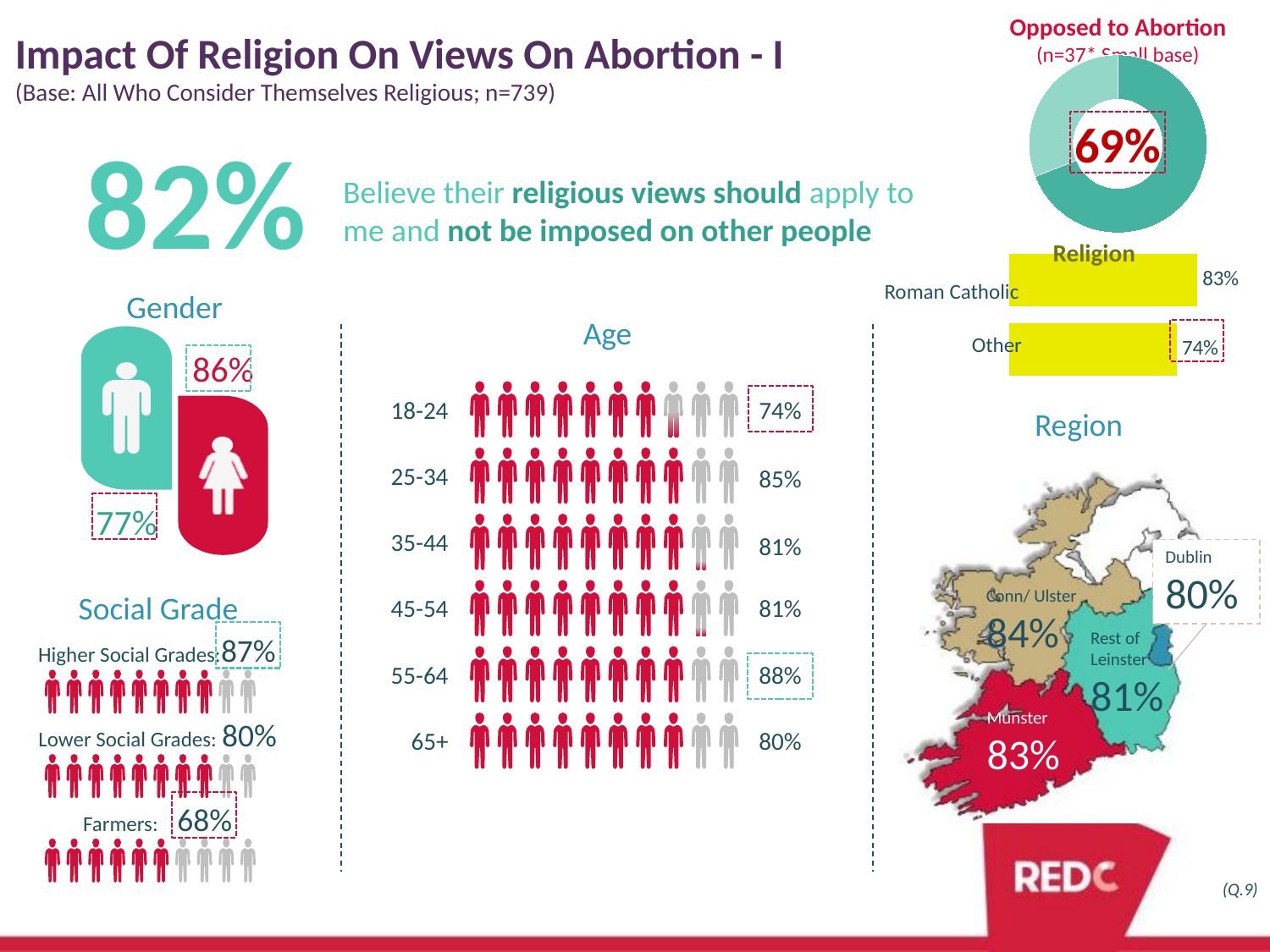
In the Religion bar chart, what is the difference between the Roman Catholic and Other values? 9 percentage points In the Age chart, what is the value for the 55-64 age group? 88% How many categories are shown in the Religion bar chart? 2 In the Religion bar chart, what is the value for Other? 74% How many age groups are shown in the Age chart? 6 In the Religion bar chart, which category has the higher value, Roman Catholic or Other? Roman Catholic What kind of chart is the Opposed to Abortion chart at the top right? Donut (pie) chart What kind of chart is the Religion chart? Bar chart In the Opposed to Abortion chart at the top right, what percentage is shown in the centre? 69% In the Age chart, which age group has the lowest value? 18-24 In the Religion bar chart, what is the value for Roman Catholic? 83% In the Age chart, which age group has the highest value? 55-64